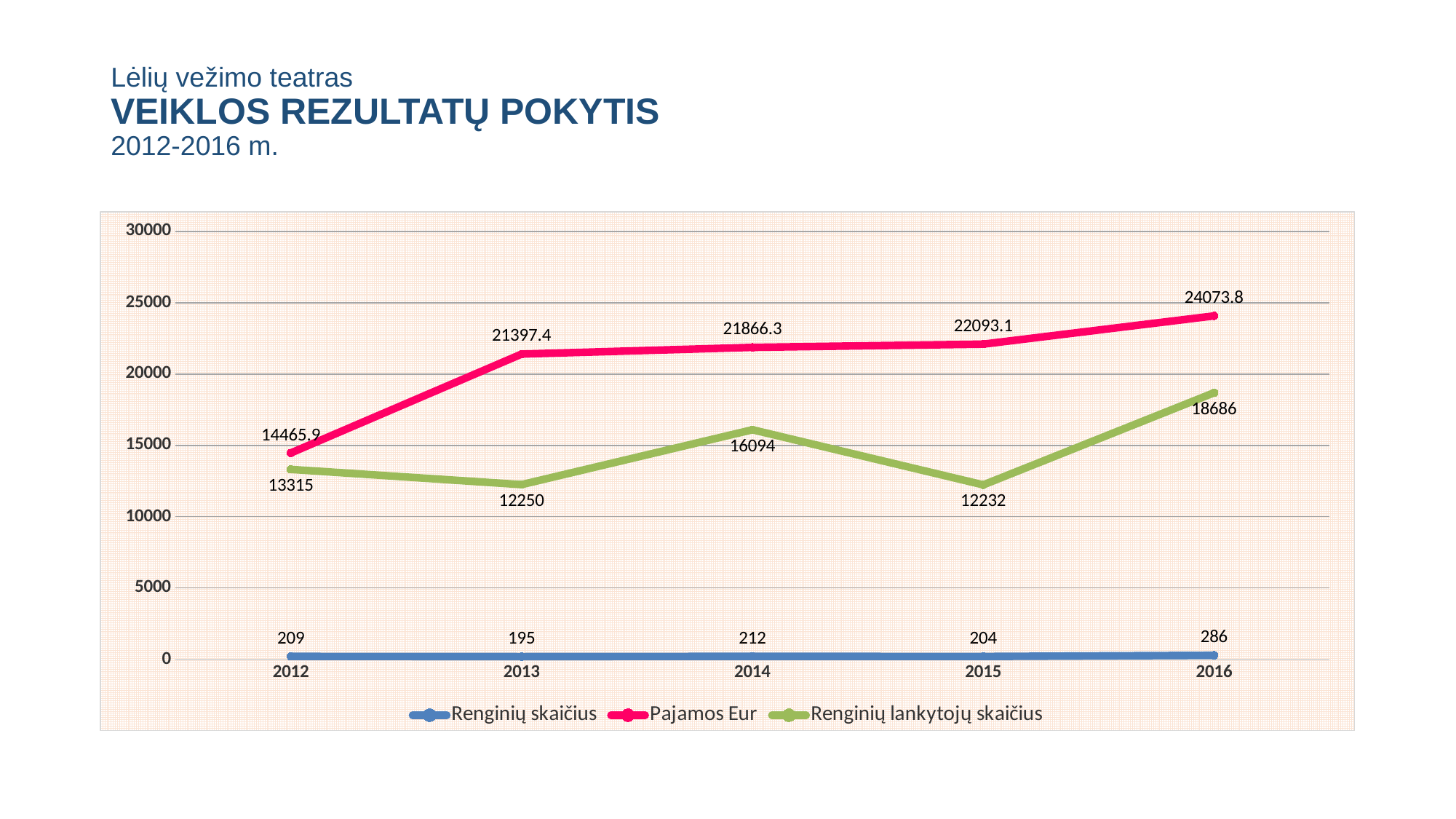
How many years are plotted along the x axis? 5 What is the value of Pajamos Eur in 2012? 14465.9 Which is larger: Renginių lankytojų skaičius in 2012 or in 2013? 2012 What is the difference between Renginių lankytojų skaičius in 2016 and in 2015? 6454 In which year is Renginių skaičius lowest? 2013 What kind of chart is shown on the slide? line chart How many series does the legend list? 3 Does Pajamos Eur rise or fall from 2012 to 2016? rise What is the value of Renginių lankytojų skaičius in 2014? 16094 In which year is Pajamos Eur highest? 2016 Which series is drawn in green? Renginių lankytojų skaičius What is the value of Renginių skaičius in 2016? 286